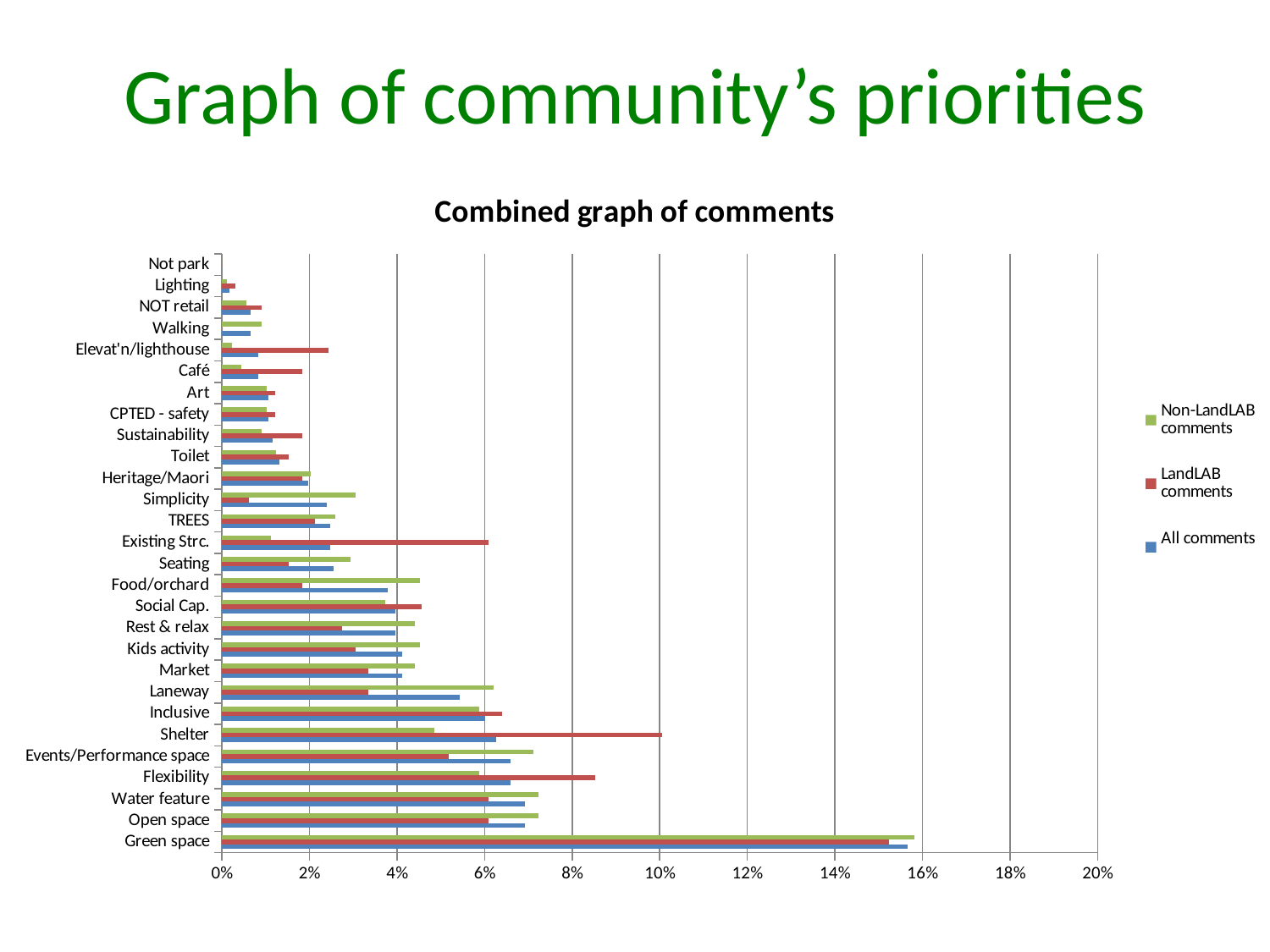
Is the LandLAB comments value for Flexibility greater or less than 8%? greater What kind of chart is shown on the slide? Bar chart How many series does the legend list? 3 Which category has the highest value for All comments? Green space How many categories are plotted on the chart? 28 For Shelter, which series has the larger value: LandLAB comments or Non-LandLAB comments? LandLAB comments Is the Non-LandLAB comments value for Simplicity greater or less than 2%? greater For Laneway, which series has the larger value: Non-LandLAB comments or LandLAB comments? Non-LandLAB comments Is the All comments value for Green space greater or less than 14%? greater Which category has the lowest values across the series? Not park What is the title of the chart? Combined graph of comments